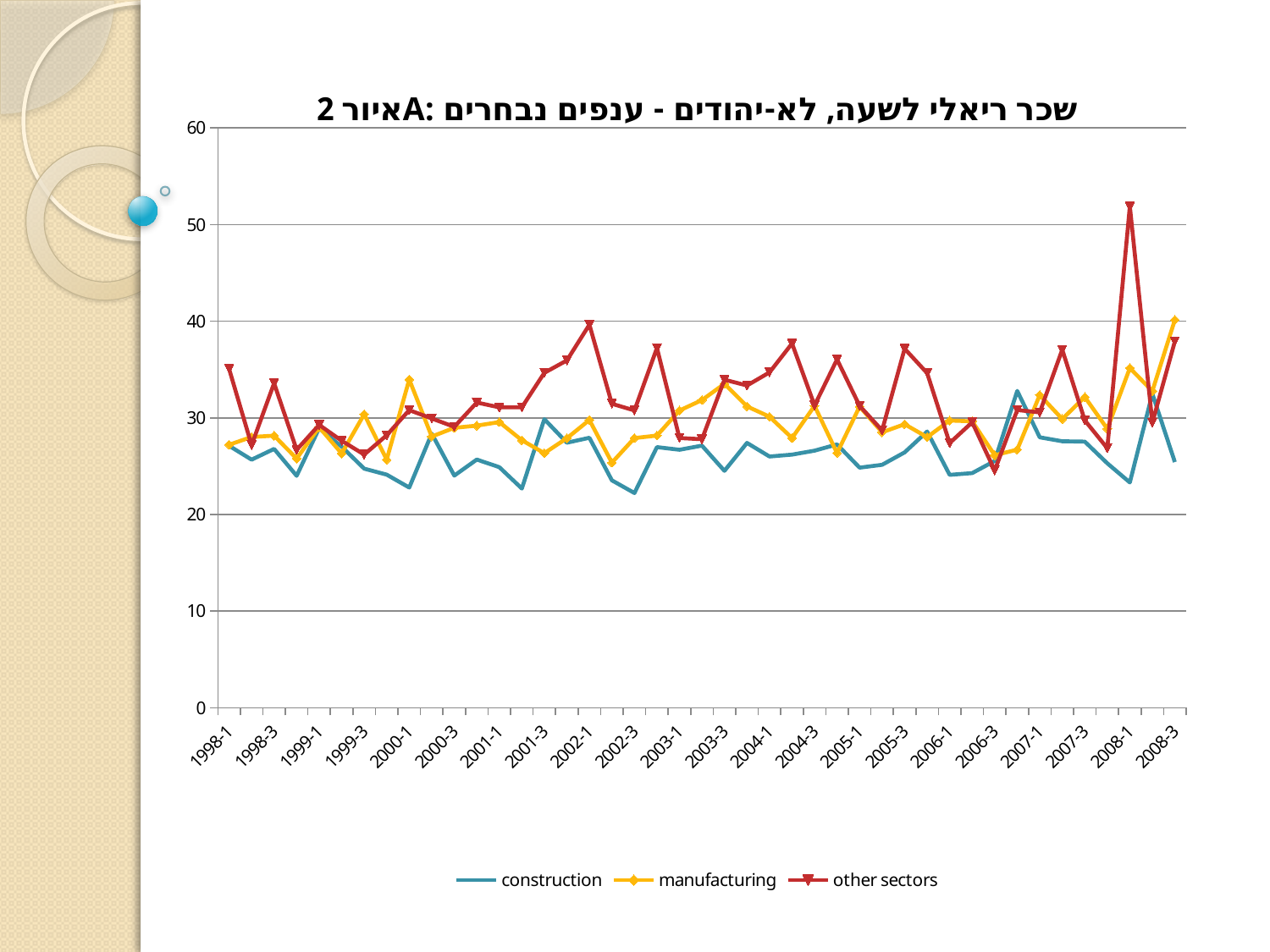
Which series are listed in the legend? construction, manufacturing, other sectors How many period labels are shown on the x axis? 22 Is the value for other sectors at 2008-1 greater or less than 50? greater At 2002-1, which is larger: other sectors or manufacturing? other sectors What kind of chart is shown on the slide? line chart At which period does the other sectors line reach its peak? 2008-1 How many series does the legend list? 3 Is the value for construction at 2008-1 greater or less than 30? less Is the value for other sectors at 1998-1 greater or less than 30? greater Which series reaches the highest value anywhere on the chart? other sectors What colour is the line for other sectors? red